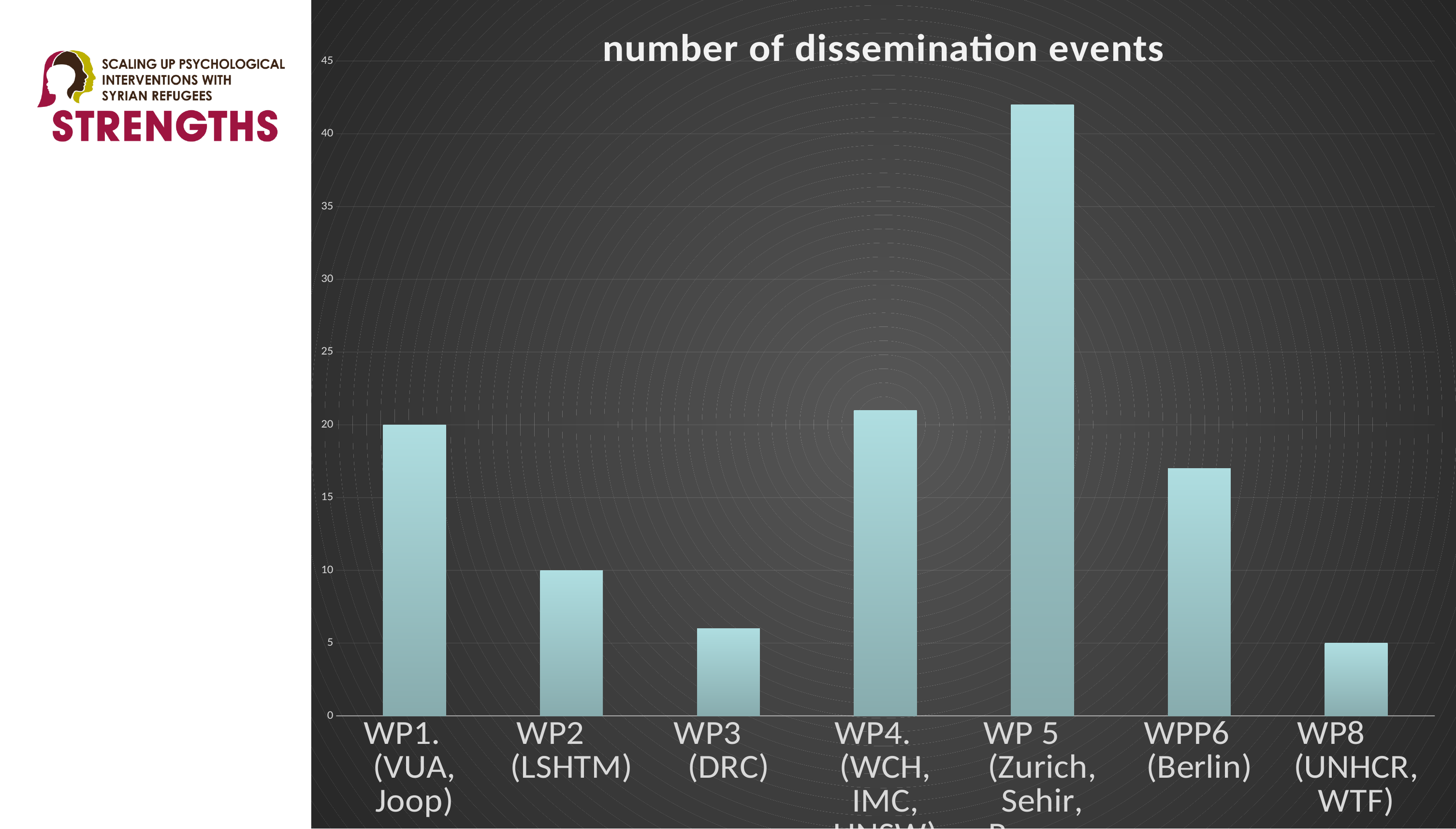
What kind of chart is shown on the slide? bar chart How many work packages (categories) are shown on the x axis? 7 What is the difference between the number of dissemination events for WP1. (VUA, Joop) and WP2 (LSHTM)? 10 How many dissemination events are shown for WP2 (LSHTM)? 10 Is the value for WP 5 (Zurich, Sehir, ...) greater or less than 40? greater Which has more dissemination events, WP1. (VUA, Joop) or WPP6 (Berlin)? WP1. (VUA, Joop) Which work package has the lowest number of dissemination events? WP8 (UNHCR, WTF) How many dissemination events are shown for WP8 (UNHCR, WTF)? 5 How many dissemination events are shown for WP1. (VUA, Joop)? 20 Is the value for WPP6 (Berlin) greater or less than 20? less What is the title of the chart? number of dissemination events Which work package has the highest number of dissemination events? WP 5 (Zurich, Sehir, ...)